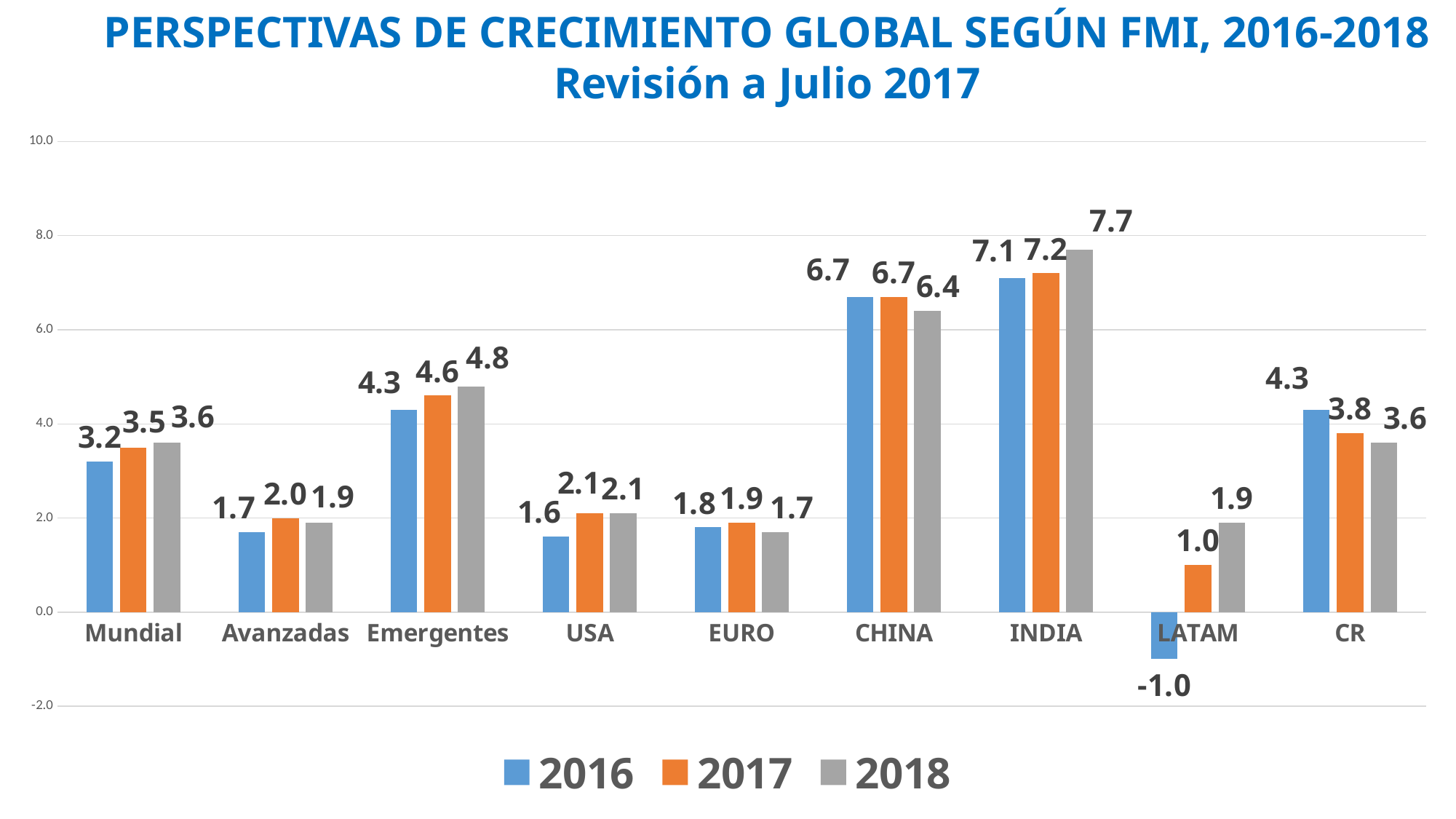
What kind of chart is shown on the slide? bar chart How many categories are shown on the x axis? 9 Which is larger for CR: the 2016 value or the 2018 value? 2016 What is the difference between the 2018 and 2016 values for INDIA? 0.6 Which category has the highest 2018 value? INDIA Do the values for Mundial rise or fall from 2016 to 2018? rise Which category has the lowest 2016 value? LATAM What is the 2016 value for CHINA? 6.7 What is the 2018 value for LATAM? 1.9 Which colour represents the 2017 series in the legend? orange How many series does the legend list? 3 What is the 2017 value for Emergentes? 4.6